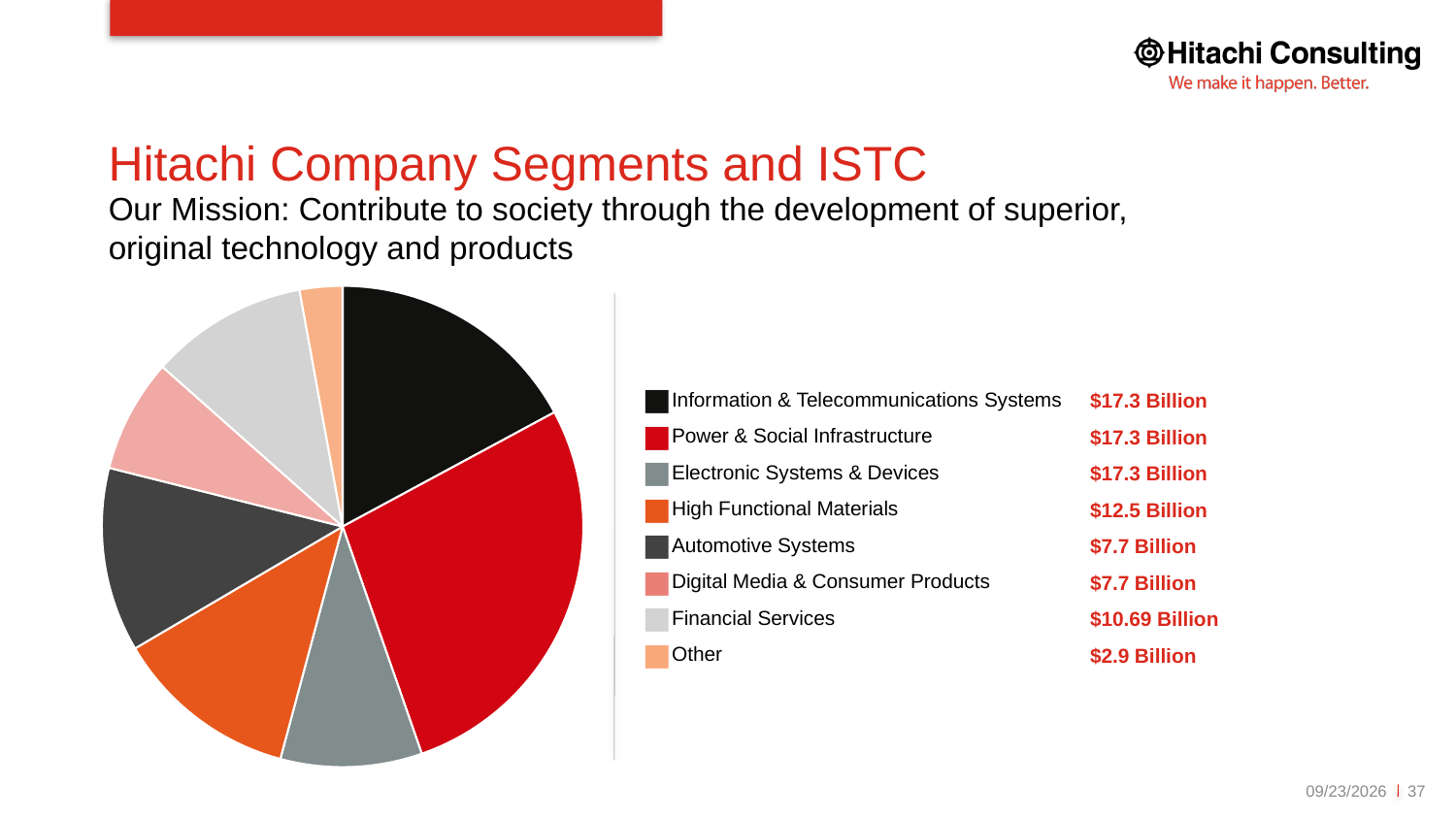
What colour represents Power & Social Infrastructure in the pie chart? Red What value is shown for Information & Telecommunications Systems? $17.3 Billion Which is larger, High Functional Materials or Other? High Functional Materials What is the difference between the values for Information & Telecommunications Systems and High Functional Materials? $4.8 Billion What is the difference between the values for Financial Services and Other? $7.79 Billion What value is shown for Other? $2.9 Billion What value is shown for Automotive Systems? $7.7 Billion What value is shown for High Functional Materials? $12.5 Billion What value is shown for Financial Services? $10.69 Billion How many segments are shown in the pie chart? 8 Which segment has the smallest value? Other What kind of chart is shown on the slide? Pie chart